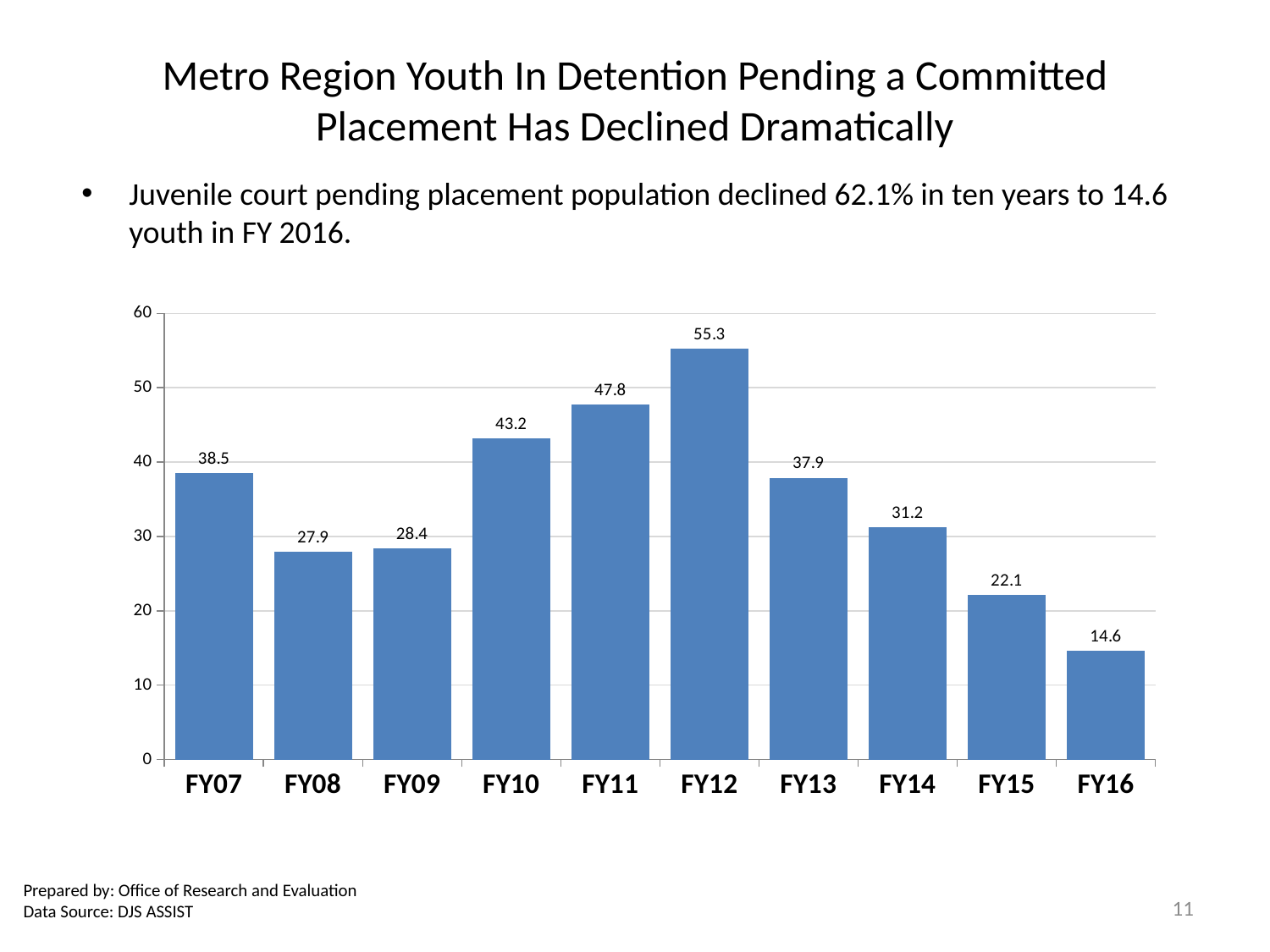
How many fiscal years are shown on the x axis? 10 What is the value for FY16? 14.6 Do the values rise or fall from FY12 to FY16? Fall What kind of chart is shown on the slide? Bar chart Which fiscal year has the lowest value? FY16 What is the difference between the values for FY08 and FY09? 0.5 What is the difference between the values for FY12 and FY16? 40.7 Which fiscal year has the highest value? FY12 Which is larger, the value for FY10 or the value for FY13? FY10 What is the value for FY07? 38.5 What is the value for FY12? 55.3 Is the value for FY11 greater or less than 40? greater